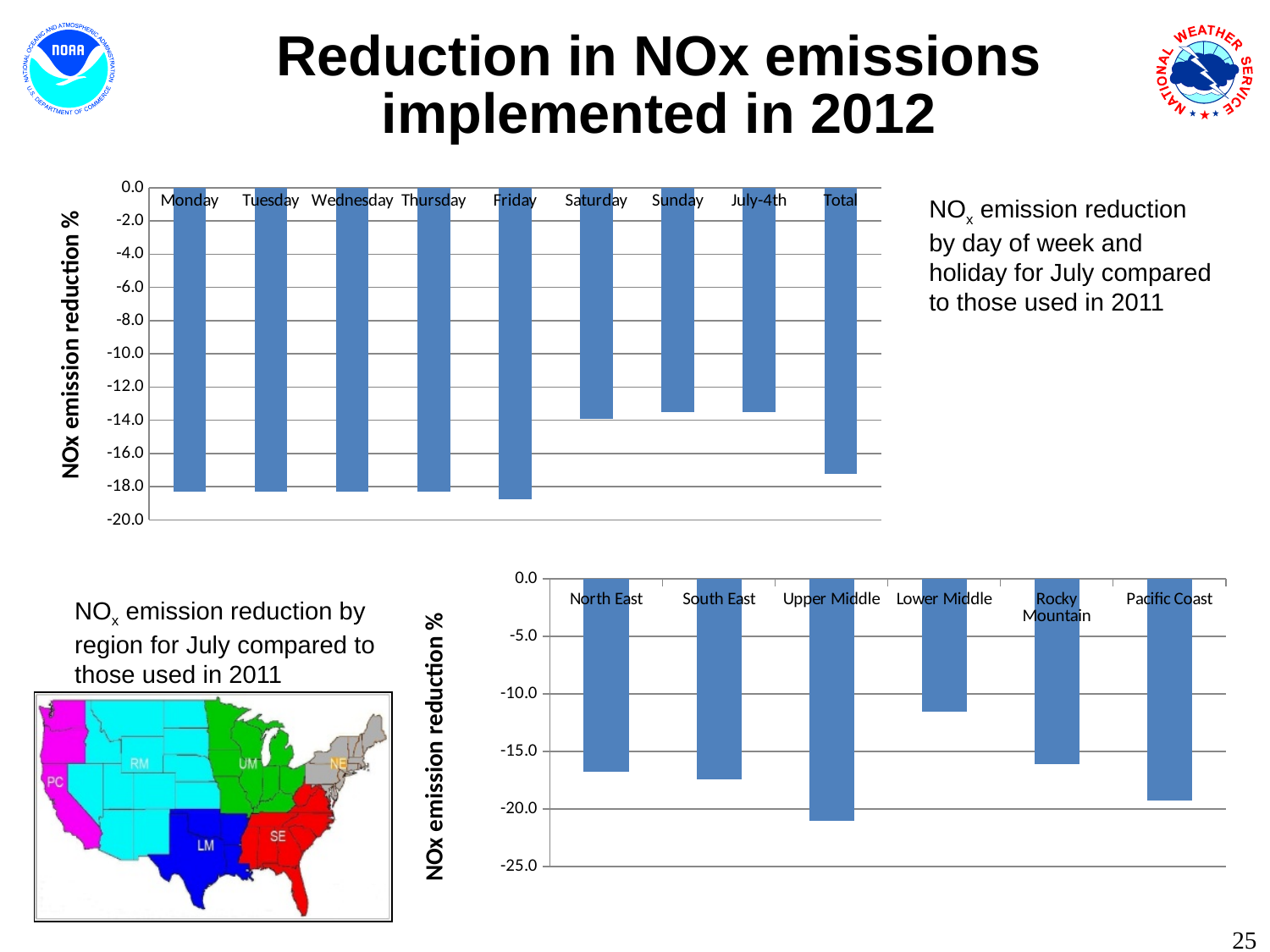
In the top chart (by day of week), is the value for Total greater or less than -16.0? less How many regions are shown in the bottom chart (by region)? 6 In the bottom chart (by region), is the value for Pacific Coast greater or less than -15.0? less How many categories are shown on the x axis of the top chart (by day of week and holiday)? 9 In the top chart (by day of week), is the value for Sunday greater or less than -16.0? greater What is the y-axis label of the top chart? NOx emission reduction % In the bottom chart (by region), which region has the lowest (most negative) value? Upper Middle In the bottom chart (by region), which bar is longer (more negative): Rocky Mountain or Pacific Coast? Pacific Coast In the top chart (by day of week), which bar is longer (more negative): Monday or Saturday? Monday What type of chart is the top chart showing NOx emission reduction by day of week? bar chart In the bottom chart (by region), which region has the highest (least negative) value? Lower Middle